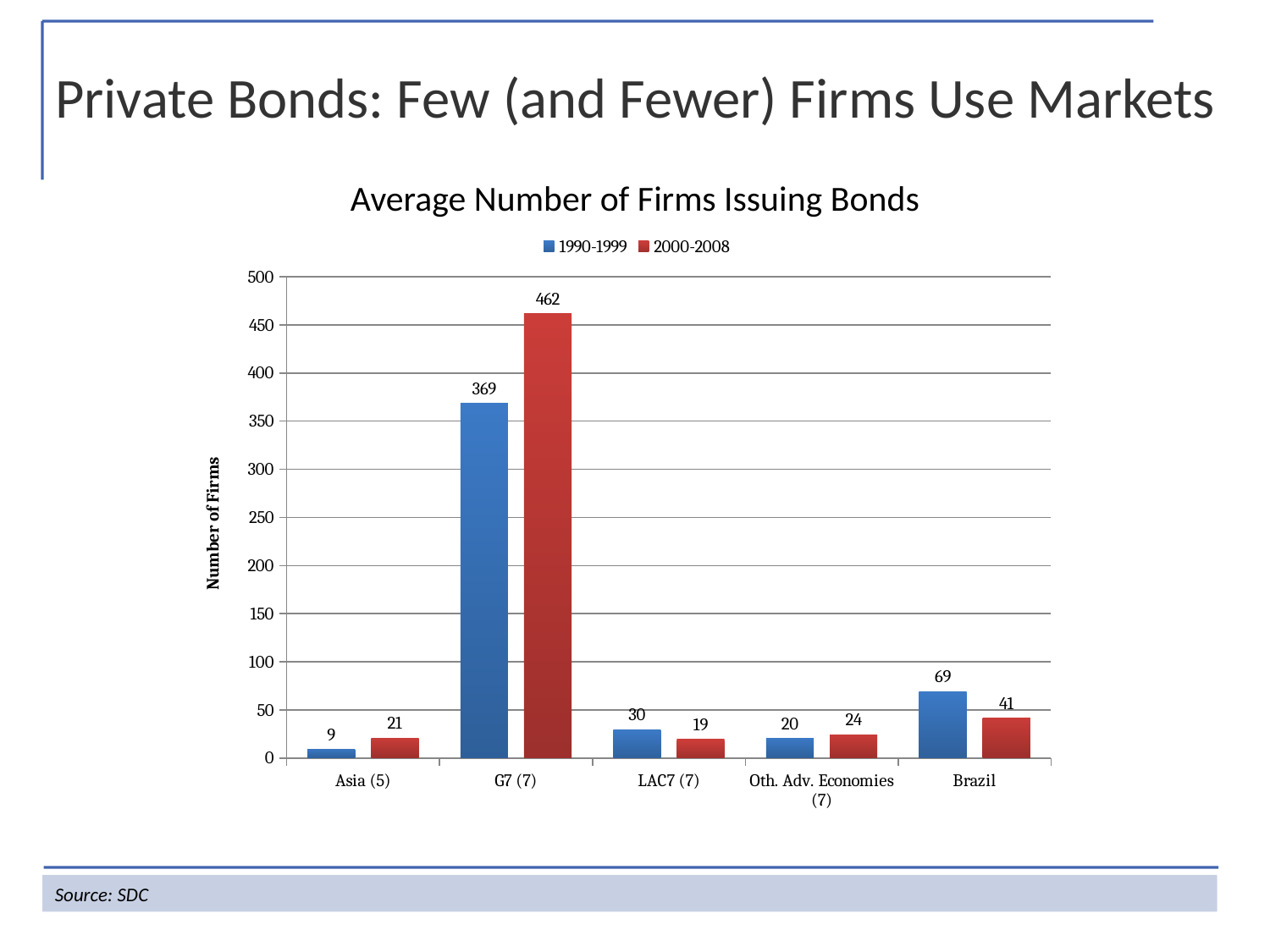
How many series does the legend list? 2 Is the value for Brazil in the 1990-1999 series greater or less than 50? greater What is the title of the chart? Average Number of Firms Issuing Bonds What is the value for Asia (5) in the 1990-1999 series? 9 What is the value for Brazil in the 1990-1999 series? 69 Which is larger for LAC7 (7): the 1990-1999 value or the 2000-2008 value? 1990-1999 What is the value for G7 (7) in the 2000-2008 series? 462 Which category has the lowest value in the 2000-2008 series? LAC7 (7) What kind of chart is shown on the slide? bar chart Which category has the highest value in the 1990-1999 series? G7 (7) How many categories are shown on the x axis? 5 What is the difference between the 2000-2008 and 1990-1999 values for G7 (7)? 93